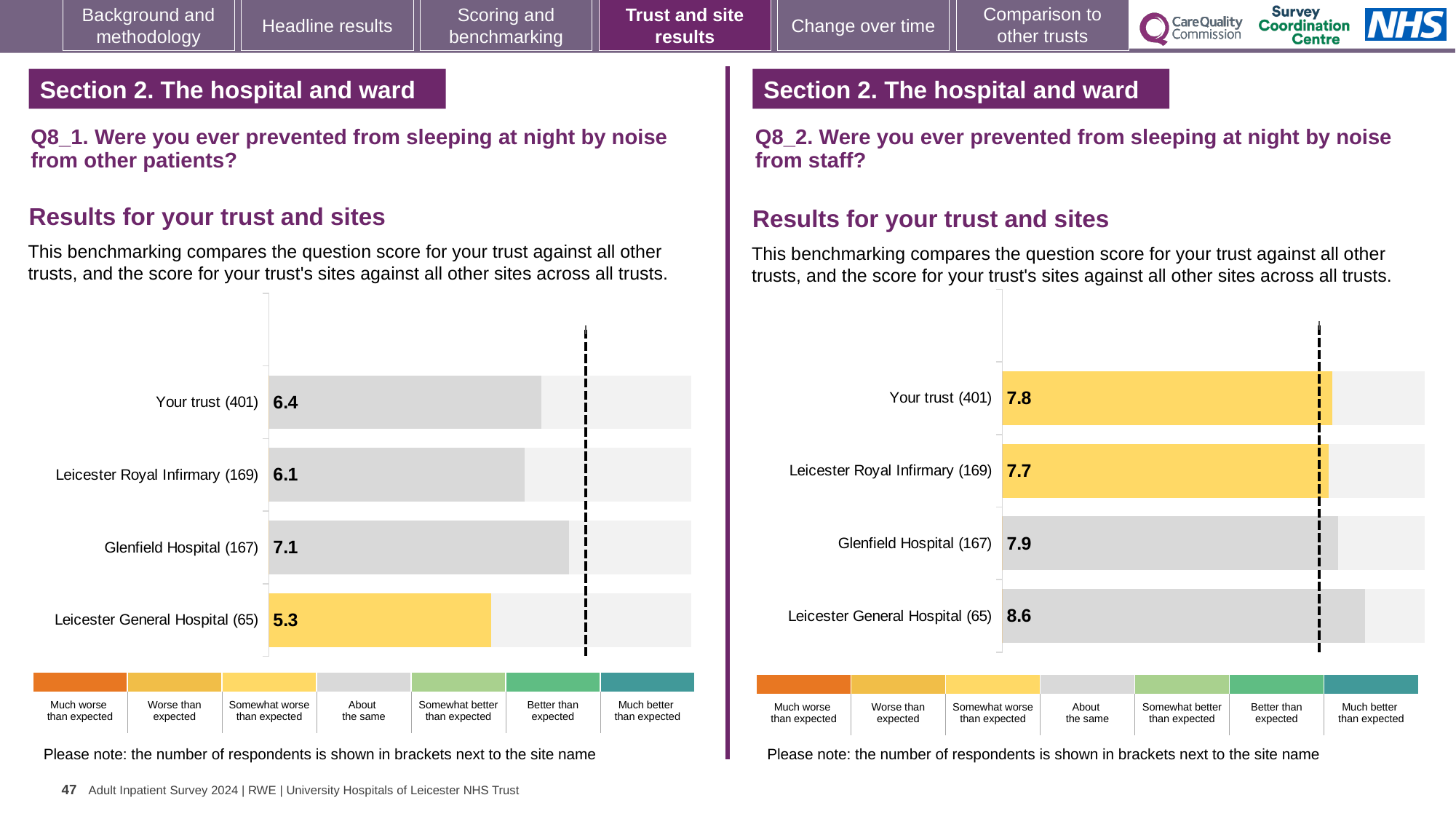
How many bars are plotted in the Q8_1 chart (left)? 4 In the Q8_2 chart (right), how many respondents are shown in brackets for Leicester Royal Infirmary? 169 In the Q8_1 chart (left), which site or trust has the lowest score? Leicester General Hospital In the Q8_2 chart (right), what is the difference between the scores for Leicester General Hospital and Leicester Royal Infirmary? 0.9 In the Q8_2 chart (right), which has the higher score, Glenfield Hospital or Your trust? Glenfield Hospital In the Q8_1 chart (left), which has the higher score, Your trust or Leicester Royal Infirmary? Your trust In the Q8_1 chart (left), what is the score for Your trust? 6.4 What kind of chart is used for the Q8_2 results (right)? Bar chart In the Q8_1 chart (left), what is the difference between the scores for Glenfield Hospital and Leicester General Hospital? 1.8 In the Q8_2 chart (right), which site or trust has the highest score? Leicester General Hospital In the Q8_2 chart (right), what is the score for Leicester General Hospital? 8.6 In the Q8_1 chart (left), what is the score for Glenfield Hospital? 7.1